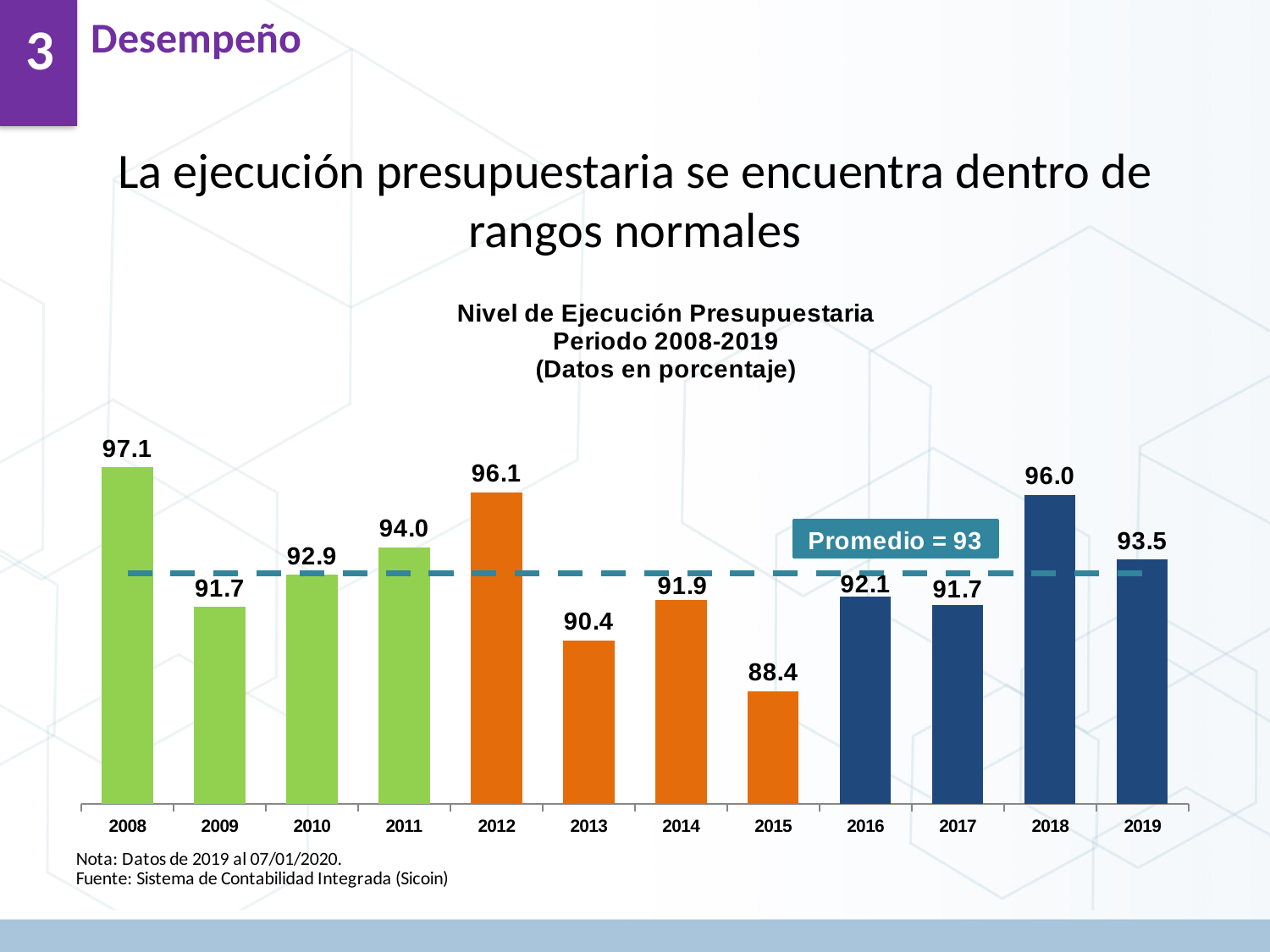
What is the title of the chart? Nivel de Ejecución Presupuestaria Periodo 2008-2019 (Datos en porcentaje) What is the difference between the values for 2012 and 2013? 5.7 Which is larger, the value for 2011 or the value for 2016? 2011 Which year has the lowest value? 2015 What kind of chart is this? Bar chart How many years are shown on the x axis? 12 What average value is shown by the dashed line label? 93 Which year has the highest value? 2008 Do the values rise or fall from 2013 to 2014? Rise What is the value for 2015? 88.4 What is the value for 2008? 97.1 What is the value for 2019? 93.5